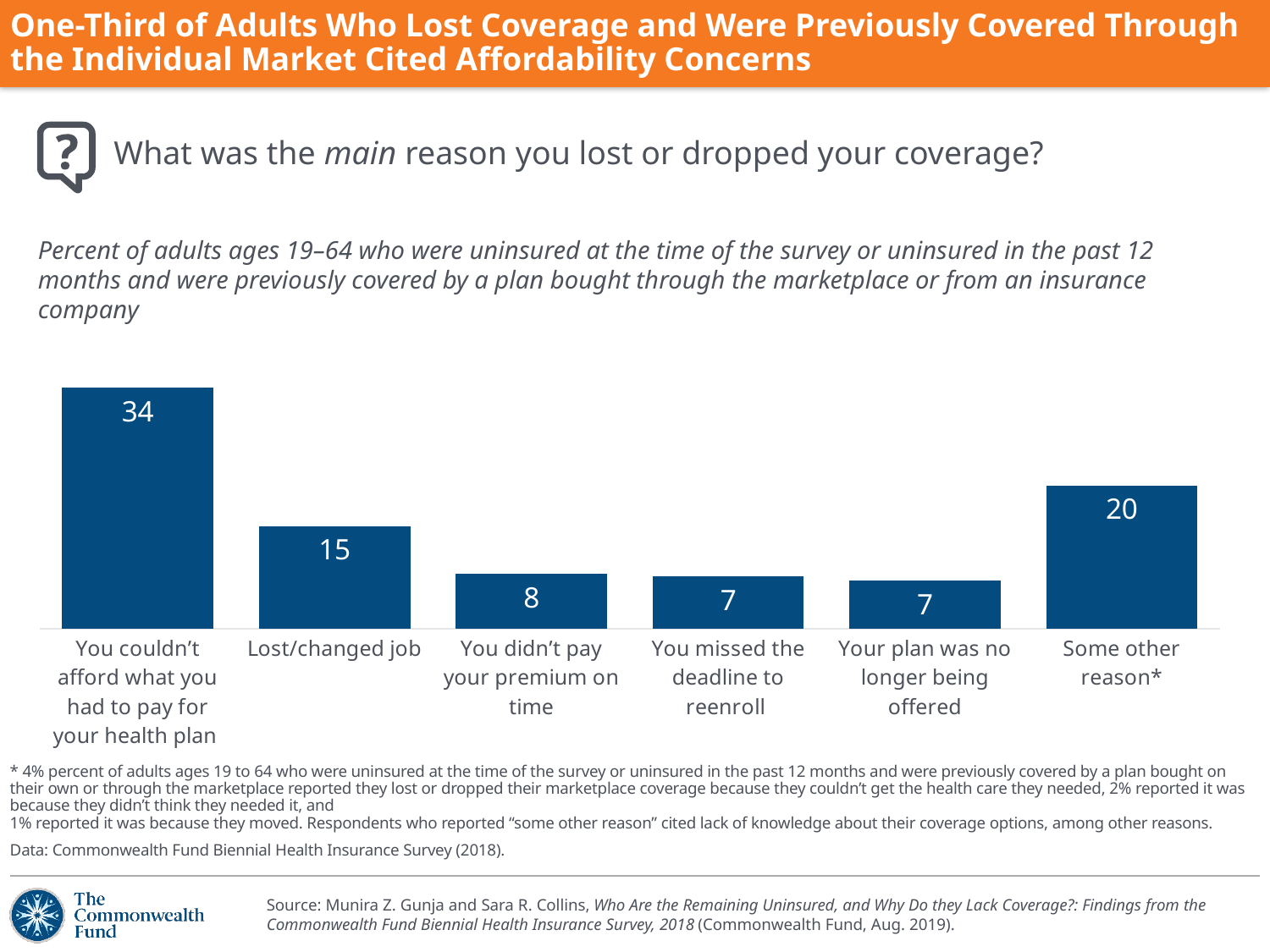
What question does the chart ask respondents, as shown above the chart? What was the main reason you lost or dropped your coverage? Which category has the highest value? You couldn't afford what you had to pay for your health plan What is the value for "You didn't pay your premium on time"? 8 How many categories are shown in the chart? 6 What is the value for "You couldn't afford what you had to pay for your health plan"? 34 What is the value for "Some other reason*"? 20 What is the difference between the values for "You couldn't afford what you had to pay for your health plan" and "Some other reason*"? 14 What is the difference between the values for "Lost/changed job" and "You didn't pay your premium on time"? 7 What value is shown for "You missed the deadline to reenroll"? 7 What is the value for "Lost/changed job"? 15 Which is larger: the value for "Lost/changed job" or the value for "Some other reason*"? Some other reason* What kind of chart is shown on the slide? Bar chart